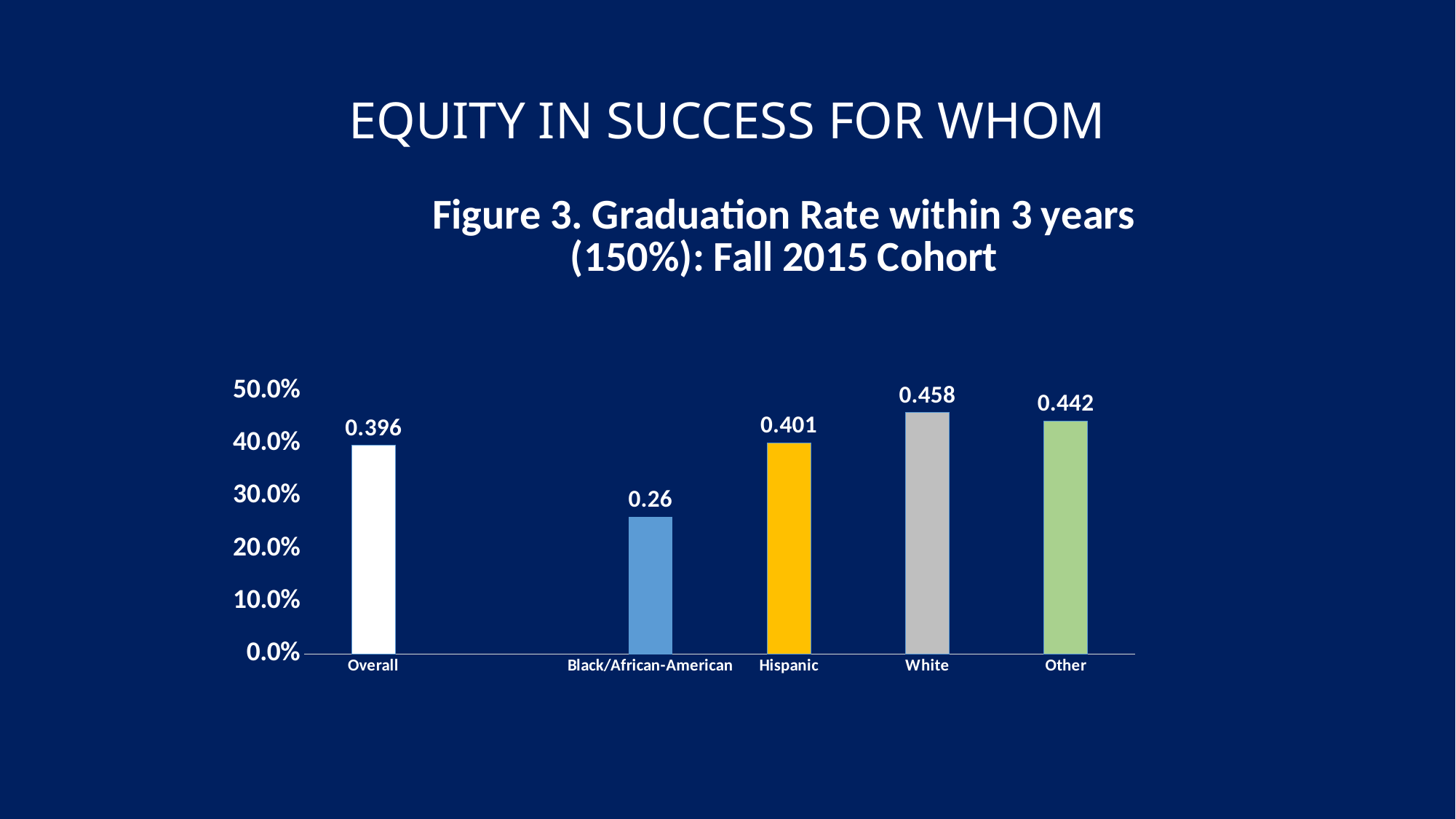
What is the value shown for Hispanic? 0.401 Which category has the lowest graduation rate? Black/African-American What is the title of the chart? Figure 3. Graduation Rate within 3 years (150%): Fall 2015 Cohort How many categories are shown on the x axis? 5 What is the graduation rate value shown for Black/African-American? 0.26 Is the value for Black/African-American greater or less than 30.0%? less What is the difference between the values for White and Black/African-American? 0.198 Which is larger, the value for Other or the value for Hispanic? Other What is the value shown for the White category? 0.458 What is the value shown for the Overall bar? 0.396 What kind of chart is shown on the slide? bar chart Which category has the highest graduation rate? White